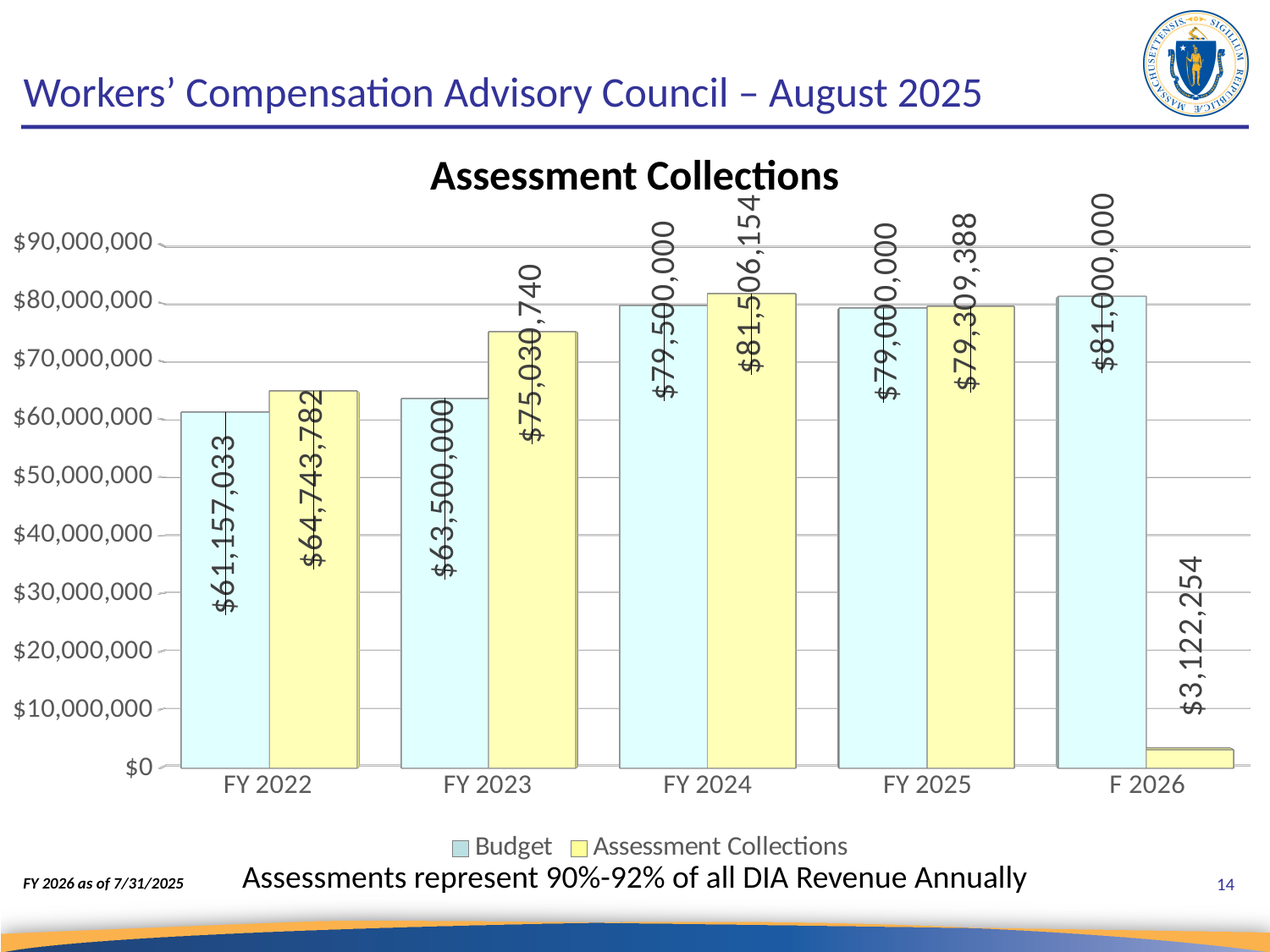
Which is larger for FY 2022, the Budget or the Assessment Collections? Assessment Collections Is the Budget value for F 2026 greater or less than $80,000,000? greater Which fiscal year has the lowest Budget value? FY 2022 What is the Budget value for FY 2024? $79,500,000 Which fiscal year has the highest Assessment Collections value? FY 2024 How many fiscal years are shown on the x axis? 5 What type of chart is shown on the slide? Bar chart What is the Assessment Collections value for FY 2023? $75,030,740 What is the Budget value for FY 2022? $61,157,033 What is the Assessment Collections value for F 2026? $3,122,254 What is the difference between Assessment Collections and Budget for FY 2023? $11,530,740 How many series does the legend list? 2